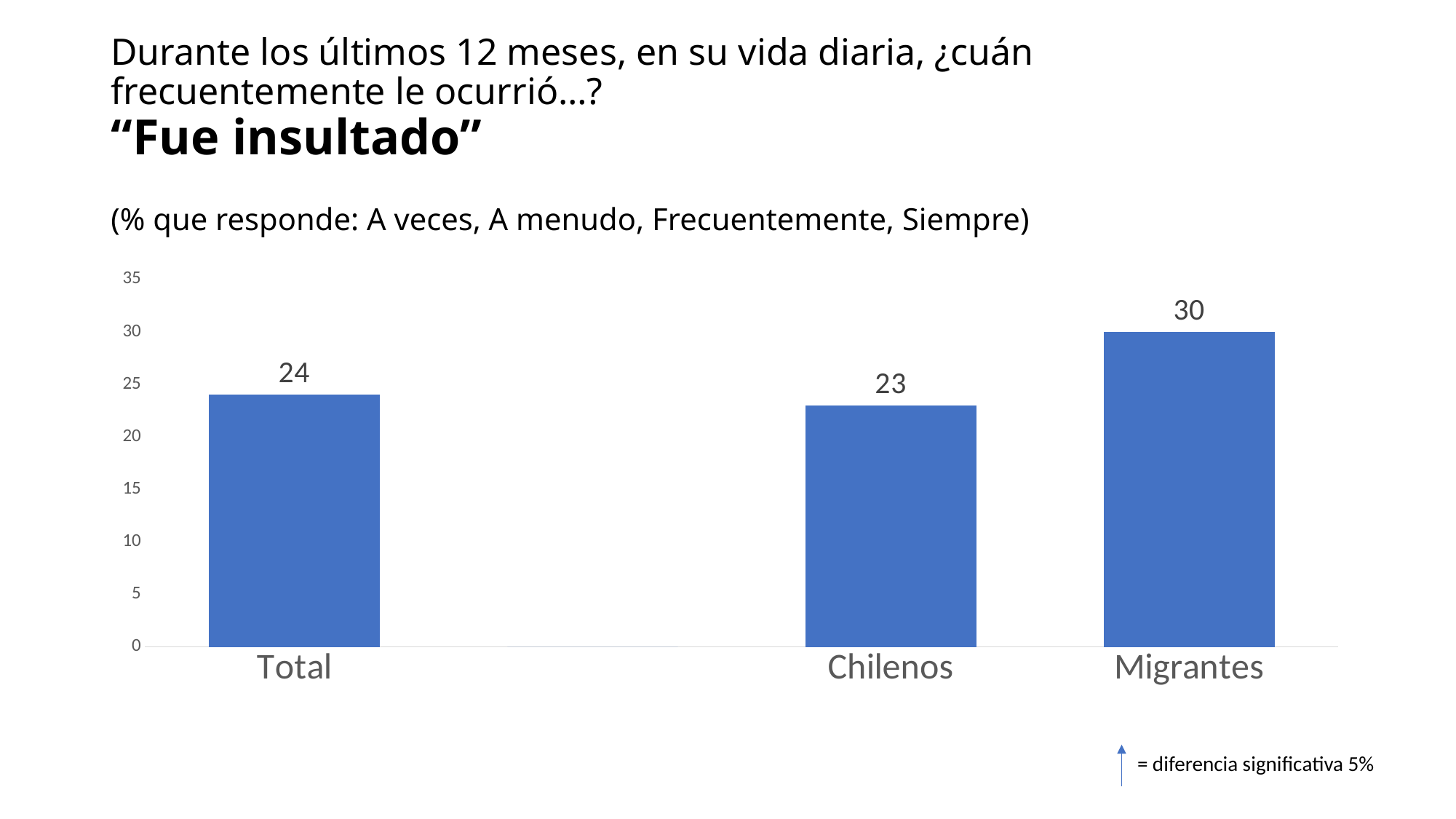
What is the difference between the values for Migrantes and Total? 6 Which category has the lowest value? Chilenos What is the value for Chilenos? 23 What is the value for Migrantes? 30 How many categories are shown on the x axis? 3 Which is larger, the value for Migrantes or the value for Total? Migrantes Is the value for Chilenos greater or less than 25? less What kind of chart is shown on the slide? bar chart What is the value for Total? 24 What is the highest value shown on the vertical axis? 35 What is the difference between the values for Migrantes and Chilenos? 7 Which category has the highest value? Migrantes